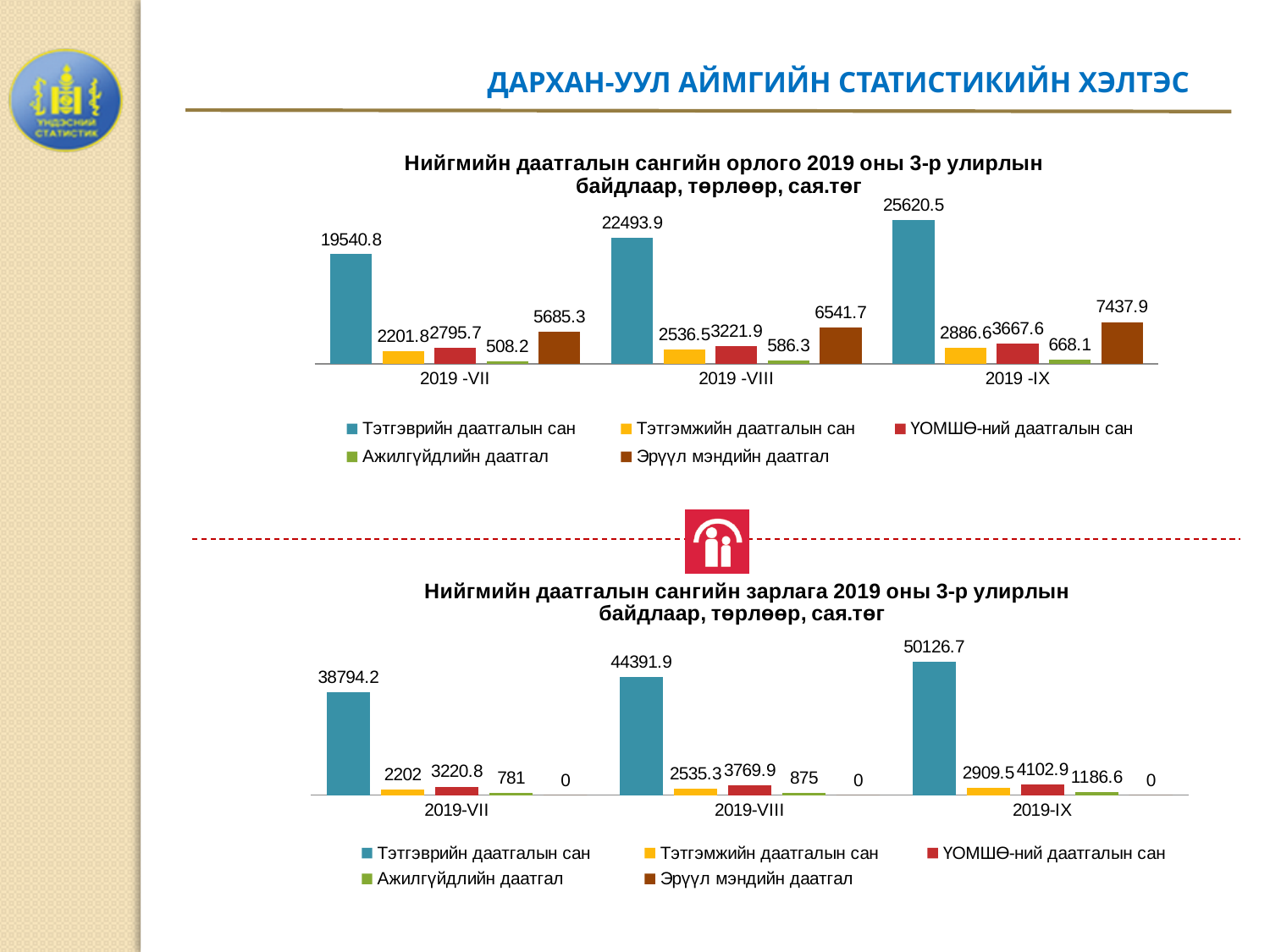
In the top chart (Нийгмийн даатгалын сангийн орлого), what is the value of Эрүүл мэндийн даатгал for 2019 -VII? 5685.3 What kind of chart is the bottom chart? Bar chart In the bottom chart (Нийгмийн даатгалын сангийн зарлага), what is the value of Ажилгүйдлийн даатгал for 2019-IX? 1186.6 In the top chart, which month has the highest value for Тэтгэврийн даатгалын сан? 2019 -IX In the bottom chart, what is the difference between Тэтгэврийн даатгалын сан in 2019-IX and in 2019-VII? 11332.5 In the bottom chart (Нийгмийн даатгалын сангийн зарлага), what is the value of Тэтгэврийн даатгалын сан for 2019-VIII? 44391.9 How many categories are shown on the x axis of the top chart? 3 How many series does the legend of the bottom chart list? 5 In the top chart, which is larger: Эрүүл мэндийн даатгал in 2019 -IX or ҮОМШӨ-ний даатгалын сан in 2019 -IX? Эрүүл мэндийн даатгал in 2019 -IX In the top chart, which series has the lowest value in 2019 -VIII? Ажилгүйдлийн даатгал In the bottom chart, does the value of Тэтгэврийн даатгалын сан rise or fall from 2019-VII to 2019-IX? Rise In the top chart (Нийгмийн даатгалын сангийн орлого), what is the value of Тэтгэврийн даатгалын сан for 2019 -IX? 25620.5